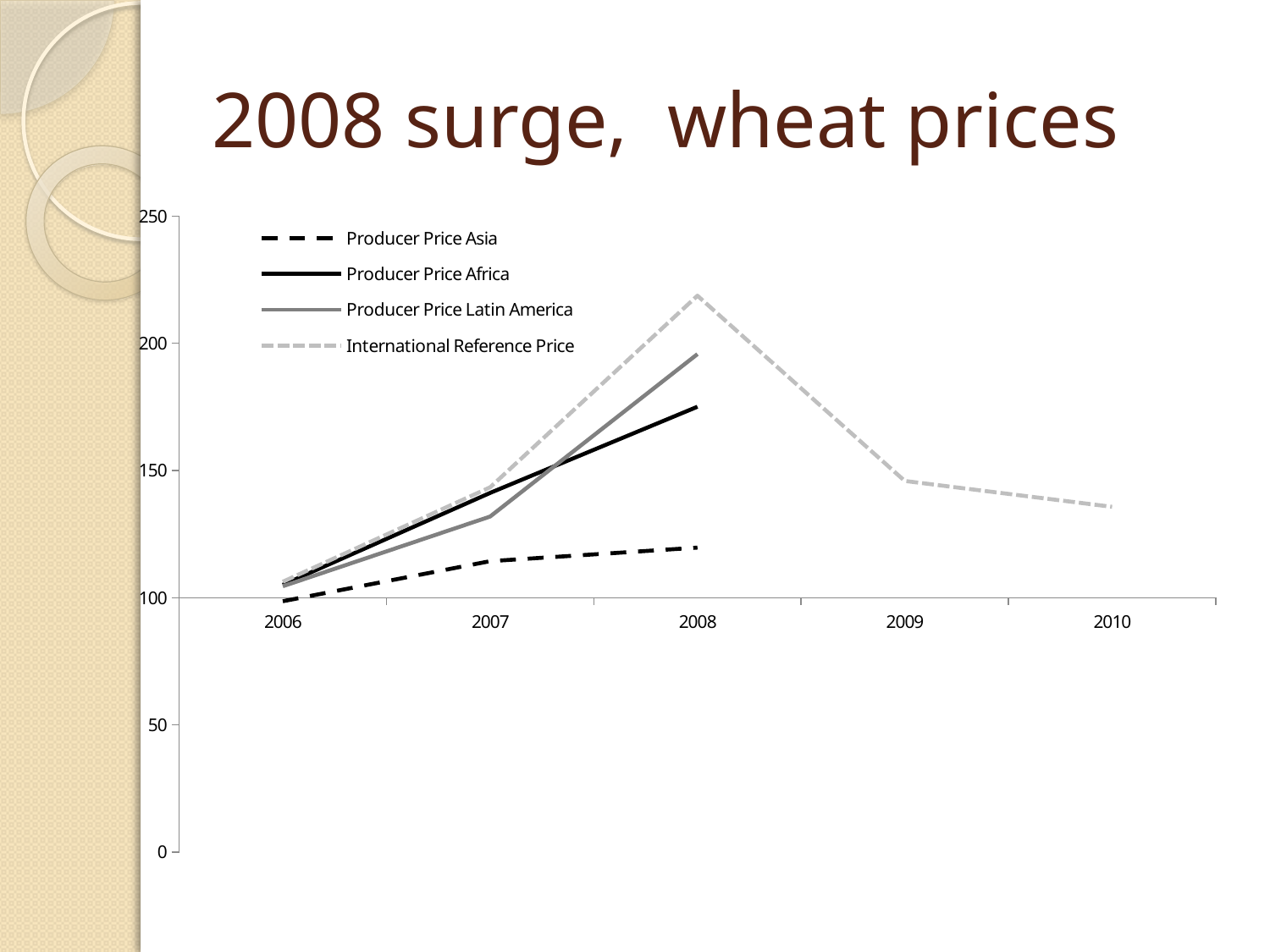
Which series reaches the highest value in 2008? International Reference Price In 2008, which is larger: Producer Price Latin America or Producer Price Africa? Producer Price Latin America Is the value for Producer Price Africa in 2008 greater or less than 150? greater How many series does the legend list? 4 What kind of chart is shown on the slide? line chart Does the International Reference Price rise or fall from 2008 to 2010? fall How many years are shown on the x axis? 5 Which series has the lowest value in 2008? Producer Price Asia Is the value for International Reference Price in 2008 greater or less than 200? greater Which series is the only one plotted through 2010? International Reference Price Is the value for Producer Price Asia in 2008 greater or less than 150? less Does Producer Price Africa rise or fall from 2006 to 2008? rise